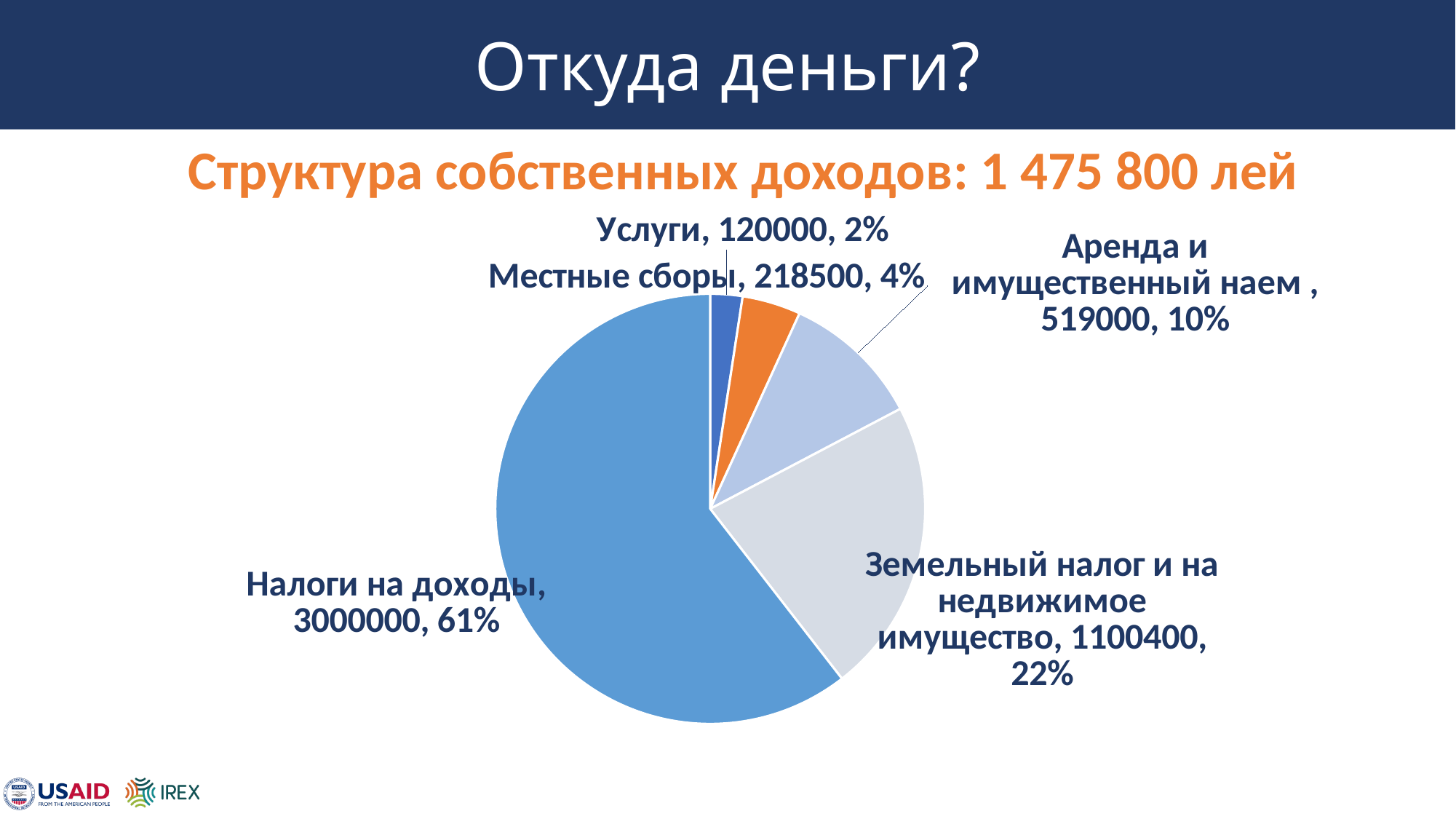
What kind of chart is shown on the slide? Pie chart Which is larger, the value for Аренда и имущественный наем or the value for Местные сборы? Аренда и имущественный наем What is the difference between the values for Местные сборы and Услуги? 98500 What is the difference in percentage points between Налоги на доходы and Земельный налог и на недвижимое имущество? 39 What is the value for Аренда и имущественный наем? 519000 Which category has the smallest slice of the pie? Услуги Which category has the largest slice of the pie? Налоги на доходы What is the value for Налоги на доходы? 3000000 How many slices does the pie chart have? 5 What total amount is stated in the chart's subtitle? 1 475 800 лей What percentage is shown for Местные сборы? 4% What share of the pie does Земельный налог и на недвижимое имущество represent? 22%